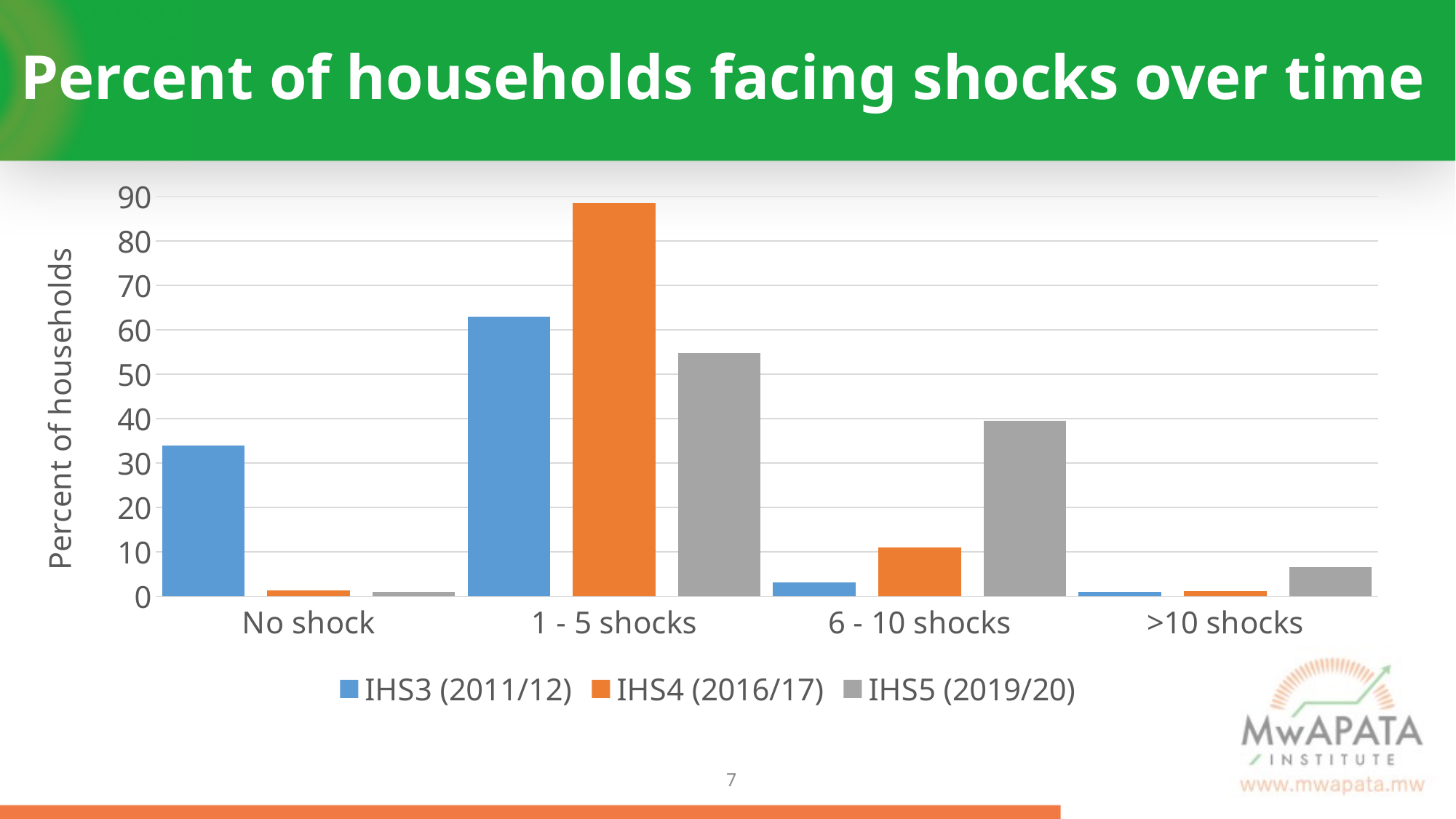
How many categories are shown on the x axis? 4 What kind of chart is shown on the slide? bar chart Is the IHS5 (2019/20) value for 6 - 10 shocks greater or less than 30? greater What is the label on the vertical axis of the chart? Percent of households In the 1 - 5 shocks category, which is larger: IHS3 (2011/12) or IHS5 (2019/20)? IHS3 (2011/12) In the 1 - 5 shocks category, which series has the highest bar? IHS4 (2016/17) How many series does the legend list? 3 Is the IHS3 (2011/12) value for No shock greater or less than 30? greater In the 6 - 10 shocks category, which series has the lowest bar? IHS3 (2011/12) For which category is the IHS4 (2016/17) bar the highest? 1 - 5 shocks Is the IHS4 (2016/17) value for 1 - 5 shocks greater or less than 80? greater In the No shock category, which is larger: IHS3 (2011/12) or IHS4 (2016/17)? IHS3 (2011/12)